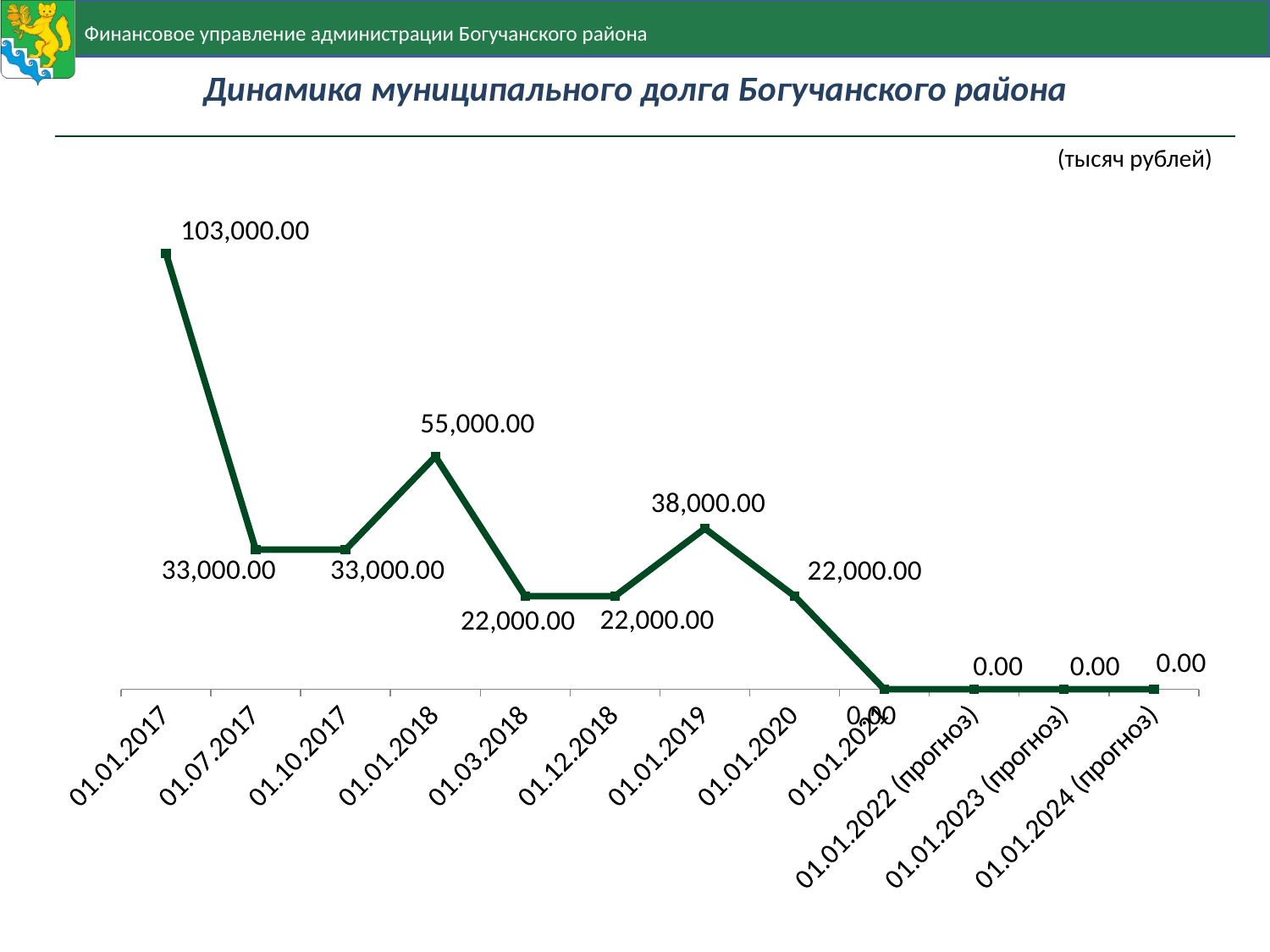
What is the value for 01.01.2020? 22,000.00 What kind of chart is shown on the slide? line chart What is the value for 01.01.2019? 38,000.00 Which date has the highest value? 01.01.2017 What is the value for 01.01.2018? 55,000.00 What is the value for 01.01.2023 (прогноз)? 0.00 How many data points are plotted on the chart? 12 What is the value for 01.01.2017? 103,000.00 Which is larger, the value for 01.01.2018 or the value for 01.01.2019? 01.01.2018 What is the difference between the values for 01.01.2018 and 01.03.2018? 33,000.00 What unit is stated for the values on the chart? тысяч рублей What is the difference between the values for 01.01.2017 and 01.07.2017? 70,000.00